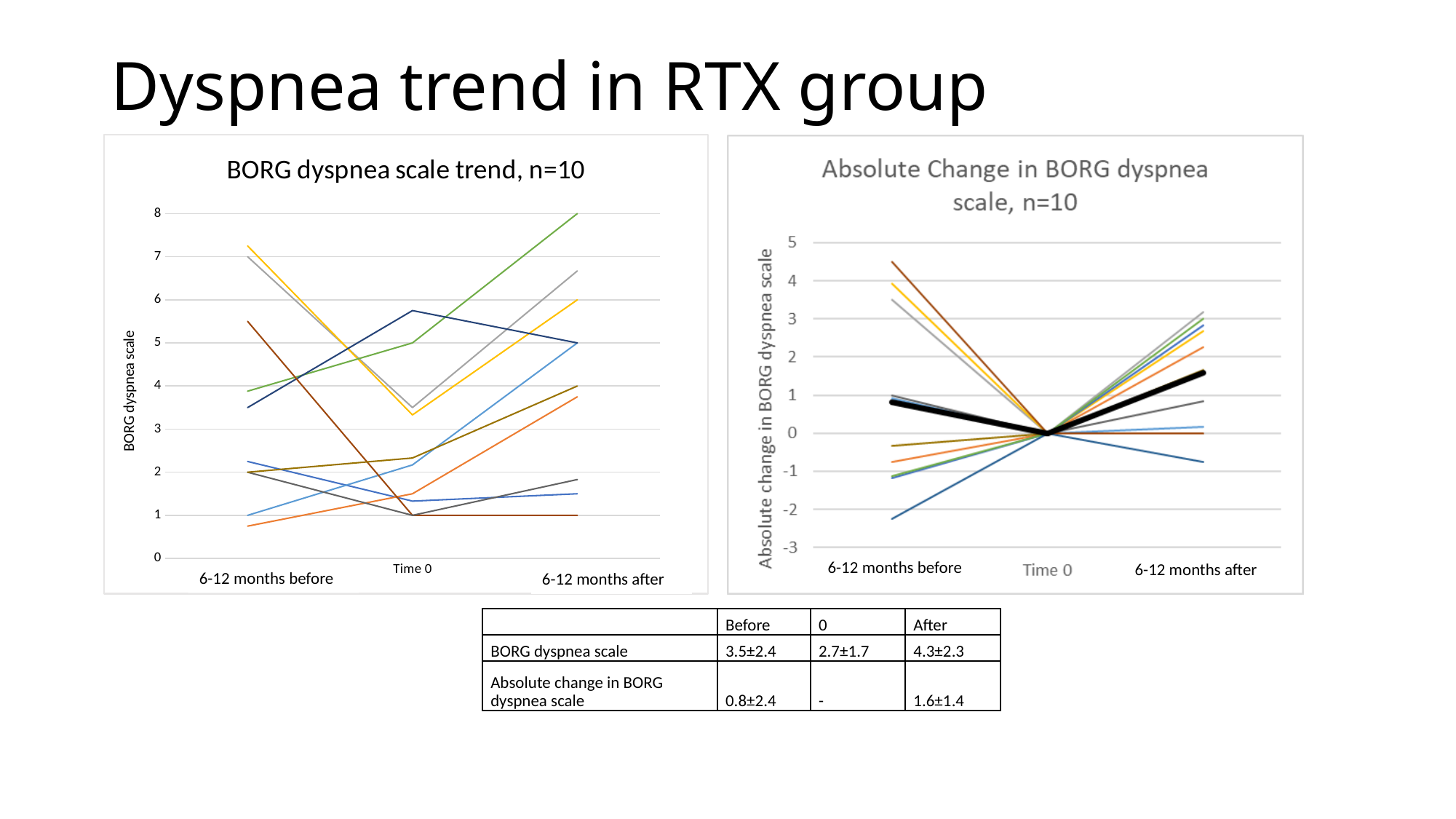
What is the title of the left chart? BORG dyspnea scale trend, n=10 In the left chart "BORG dyspnea scale trend, n=10", is the value of the brown line at 6-12 months before greater or less than 5? greater In the left chart "BORG dyspnea scale trend, n=10", is the value of the green line at 6-12 months after greater or less than 7? greater In the right chart "Absolute Change in BORG dyspnea scale, n=10", is the value of the thick black line at 6-12 months after greater or less than 1? greater What is the highest value shown on the y axis of the right chart "Absolute Change in BORG dyspnea scale, n=10"? 5 What kind of chart is the right chart titled "Absolute Change in BORG dyspnea scale, n=10"? line chart In the right chart "Absolute Change in BORG dyspnea scale, n=10", does the thick black line rise or fall from Time 0 to 6-12 months after? rise What is the y-axis label of the right chart "Absolute Change in BORG dyspnea scale, n=10"? Absolute change in BORG dyspnea scale How many time points are shown on the x axis of the left chart "BORG dyspnea scale trend, n=10"? 3 How many time points are shown on the x axis of the right chart "Absolute Change in BORG dyspnea scale, n=10"? 3 What kind of chart is the left chart titled "BORG dyspnea scale trend, n=10"? line chart